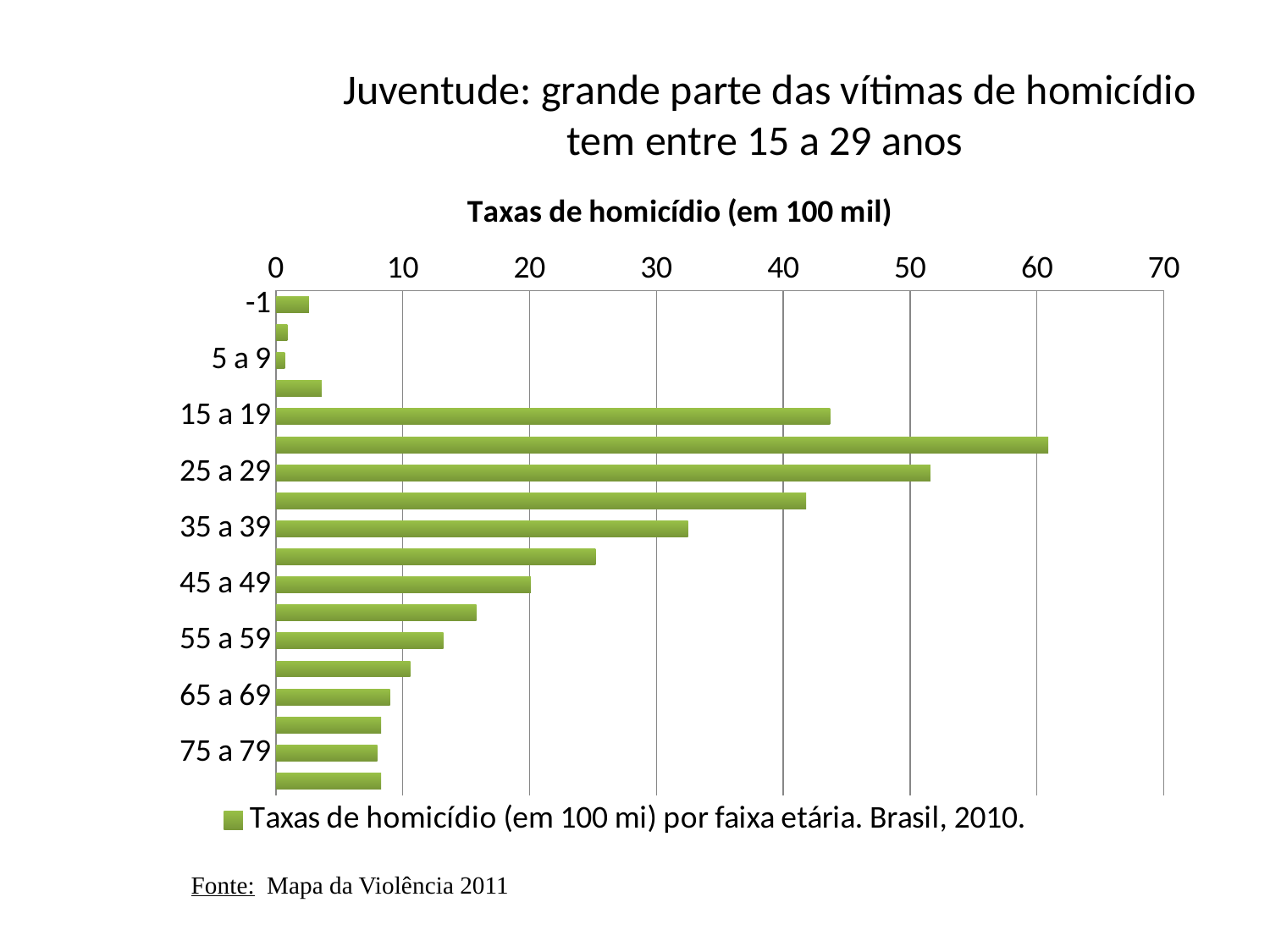
Which has the larger value, 25 a 29 or 45 a 49? 25 a 29 What kind of chart is shown on the slide? bar chart Is the value for 35 a 39 greater or less than 30? greater Is the value for 5 a 9 greater or less than 10? less Is the value for 15 a 19 greater or less than 40? greater What is the highest value shown on the horizontal axis? 70 How many bars are plotted in the chart? 18 What is the title of the chart? Taxas de homicídio (em 100 mil) Which has the larger value, 15 a 19 or 35 a 39? 15 a 19 How many series does the legend list? 1